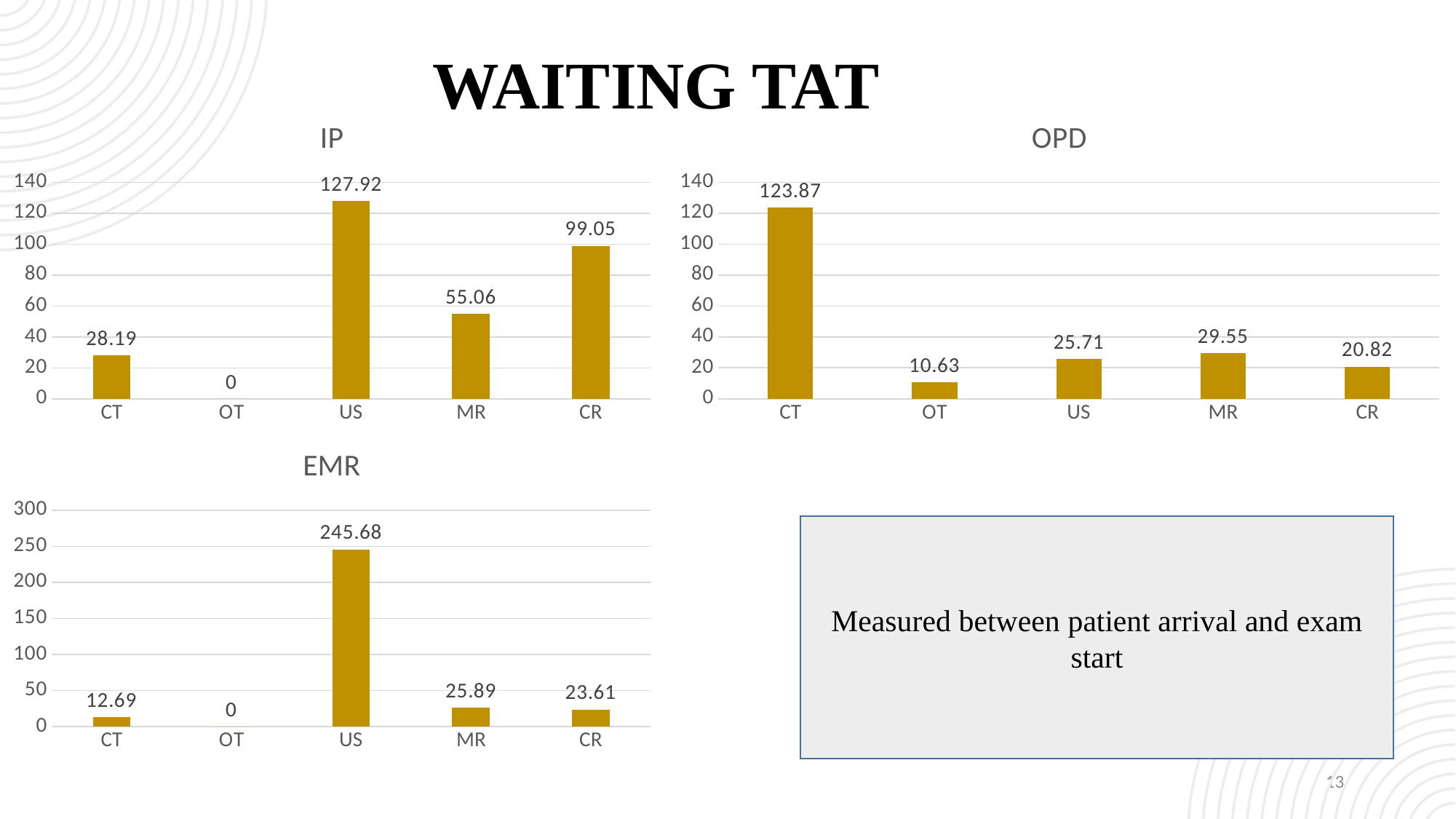
In the OPD chart, what is the value for US? 25.71 In the OPD chart, which category has the highest value? CT In the IP chart, what is the value for US? 127.92 In the IP chart, is the value for CR greater or less than 100? less What kind of chart is the EMR chart? bar chart How many charts are shown on the slide? 3 In the EMR chart, which is larger, the value for MR or the value for CR? MR In the EMR chart, what is the value for MR? 25.89 In the EMR chart, what is the difference between the values for US and CT? 232.99 How many categories are shown in the OPD chart? 5 In the IP chart, which category has the lowest value? OT In the OPD chart, what is the difference between the values for CT and OT? 113.24